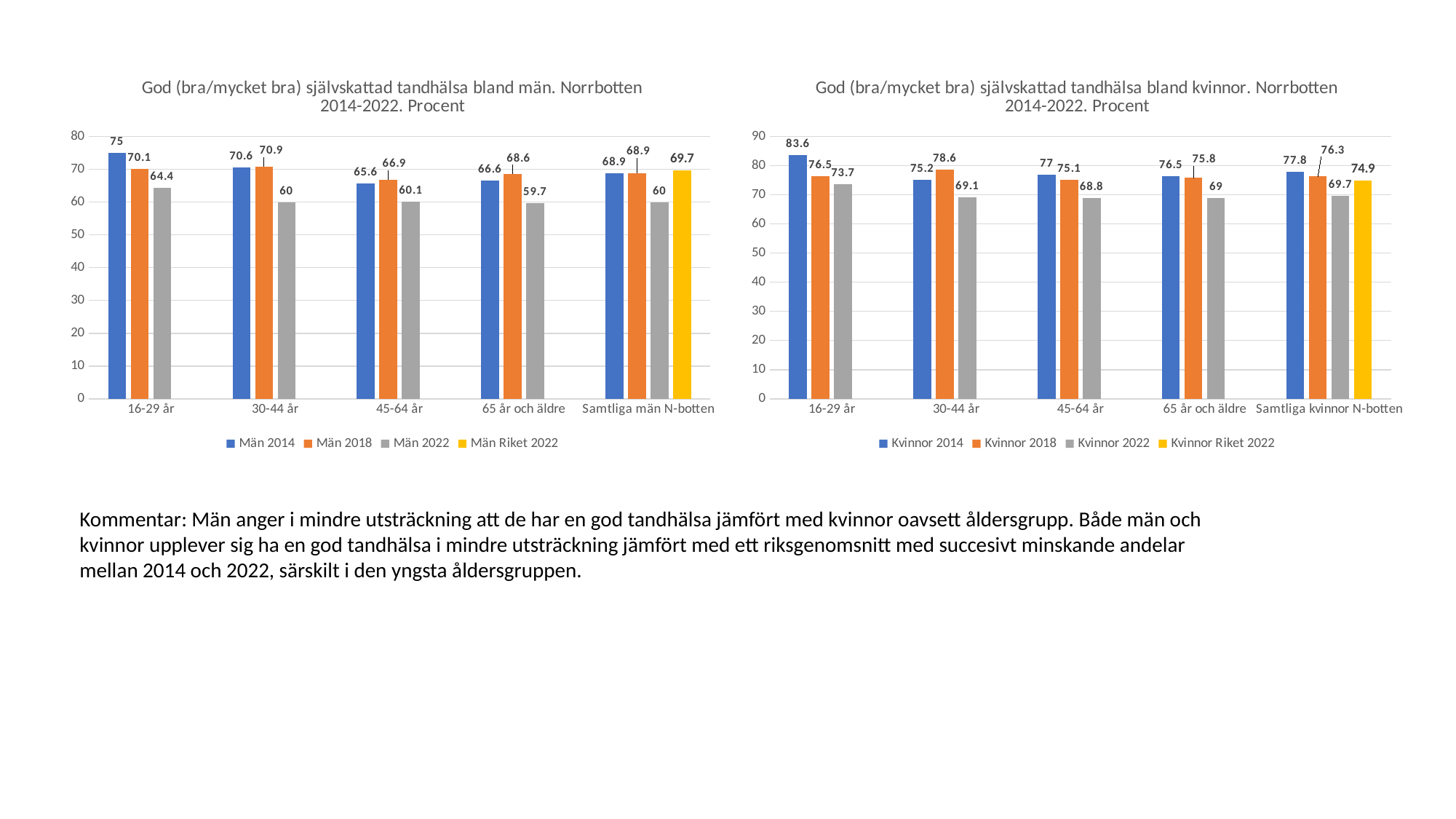
In the right chart (women), which is larger for Samtliga kvinnor N-botten: Kvinnor 2022 or Kvinnor Riket 2022? Kvinnor Riket 2022 In the left chart (men), which age group has the lowest Män 2022 value? 65 år och äldre How many categories are shown on the x axis of the right chart (women)? 5 What kind of chart is the left chart (men)? Bar chart How many series does the legend of the left chart (men) list? 4 In the left chart (men), what is the value for Män Riket 2022 for Samtliga män N-botten? 69.7 In the right chart (women), what is the value for Kvinnor 2018 in the 30-44 år group? 78.6 In the right chart (women), which category has the highest Kvinnor 2014 value? 16-29 år In the right chart (women), what is the value for Kvinnor 2022 in the 16-29 år group? 73.7 In the left chart (men), what is the value for Män 2014 in the 16-29 år group? 75 In the left chart (men), what is the difference between Män 2014 and Män 2022 in the 16-29 år group? 10.6 In the right chart (women), what is the difference between Kvinnor 2014 and Kvinnor 2022 in the 16-29 år group? 9.9